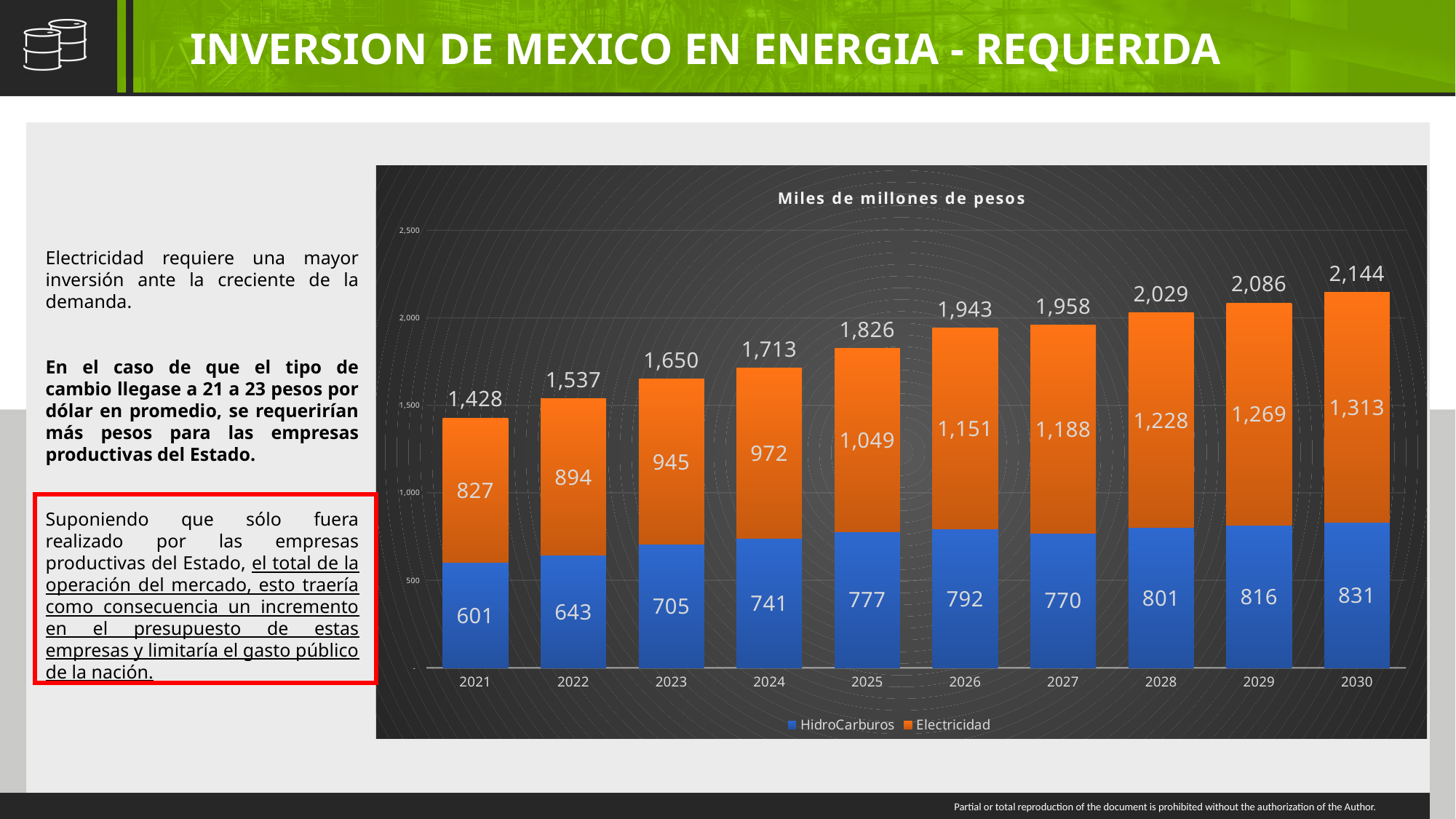
How many series does the legend list? 2 What is the value for HidroCarburos in 2025? 777 What kind of chart is shown on the slide? Stacked bar chart What is the title of the chart? Miles de millones de pesos What is the value for Electricidad in 2028? 1,228 Is the total for 2027 greater or less than 2,000? less Which is larger, the HidroCarburos value in 2026 or in 2027? 2026 Which year has the lowest value for HidroCarburos? 2021 What is the difference between the Electricidad value in 2030 and in 2021? 486 What is the total of the stacked bar for 2030? 2,144 Which year has the highest value for Electricidad? 2030 How many years are shown on the x axis? 10